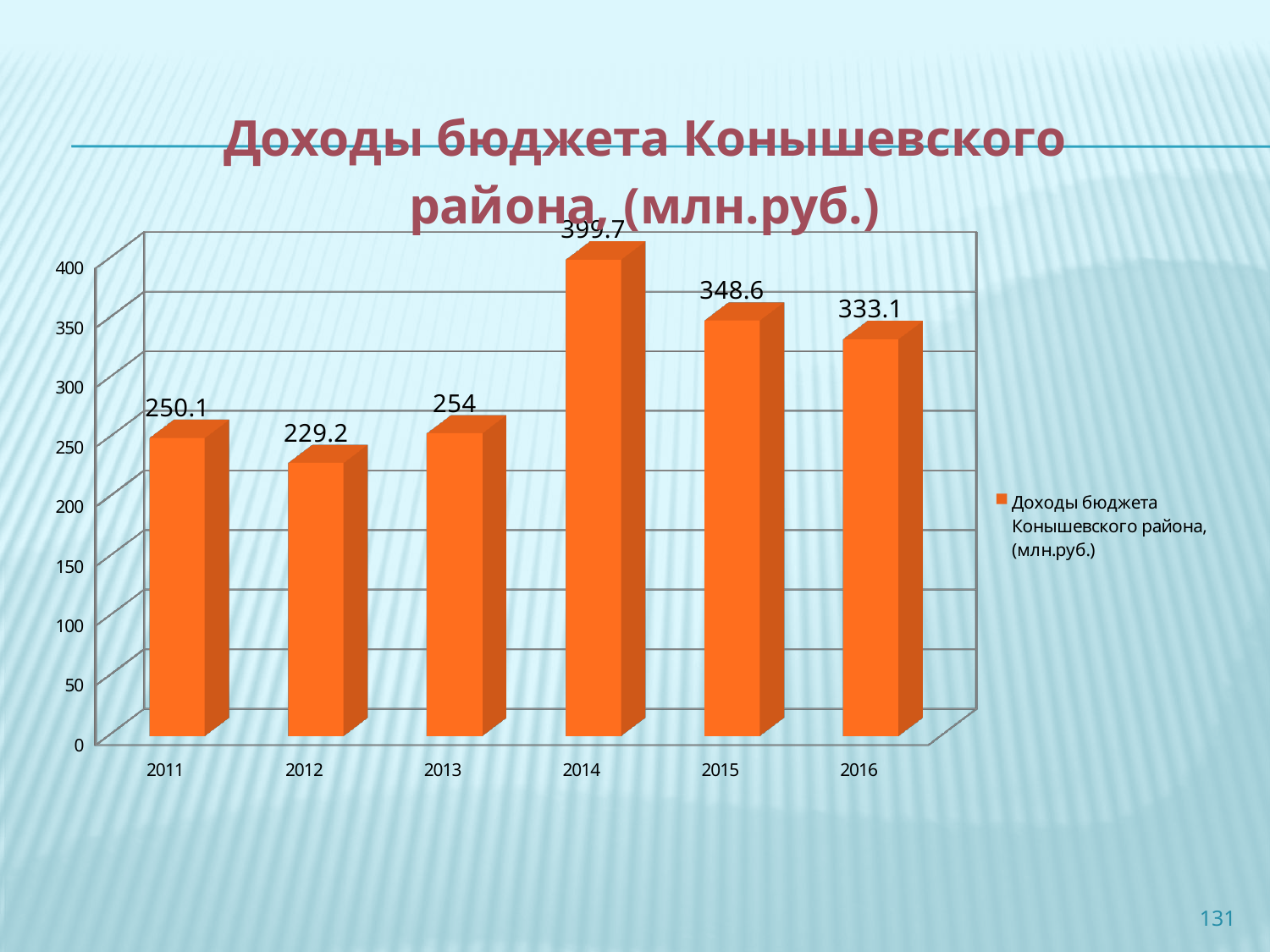
Which year has a larger budget revenue, 2015 or 2016? 2015 Which year has the highest budget revenue? 2014 Is the value for 2013 greater or less than 300? less How many years are shown on the x axis? 6 What kind of chart is shown on the slide? bar chart What is the difference between the budget revenue in 2014 and in 2015? 51.1 Does the budget revenue rise or fall from 2014 to 2016? fall What is the difference between the budget revenue in 2013 and in 2011? 3.9 What is the budget revenue value for 2014? 399.7 Which year has the lowest budget revenue? 2012 What is the budget revenue value for 2012? 229.2 What is the budget revenue value for 2016? 333.1